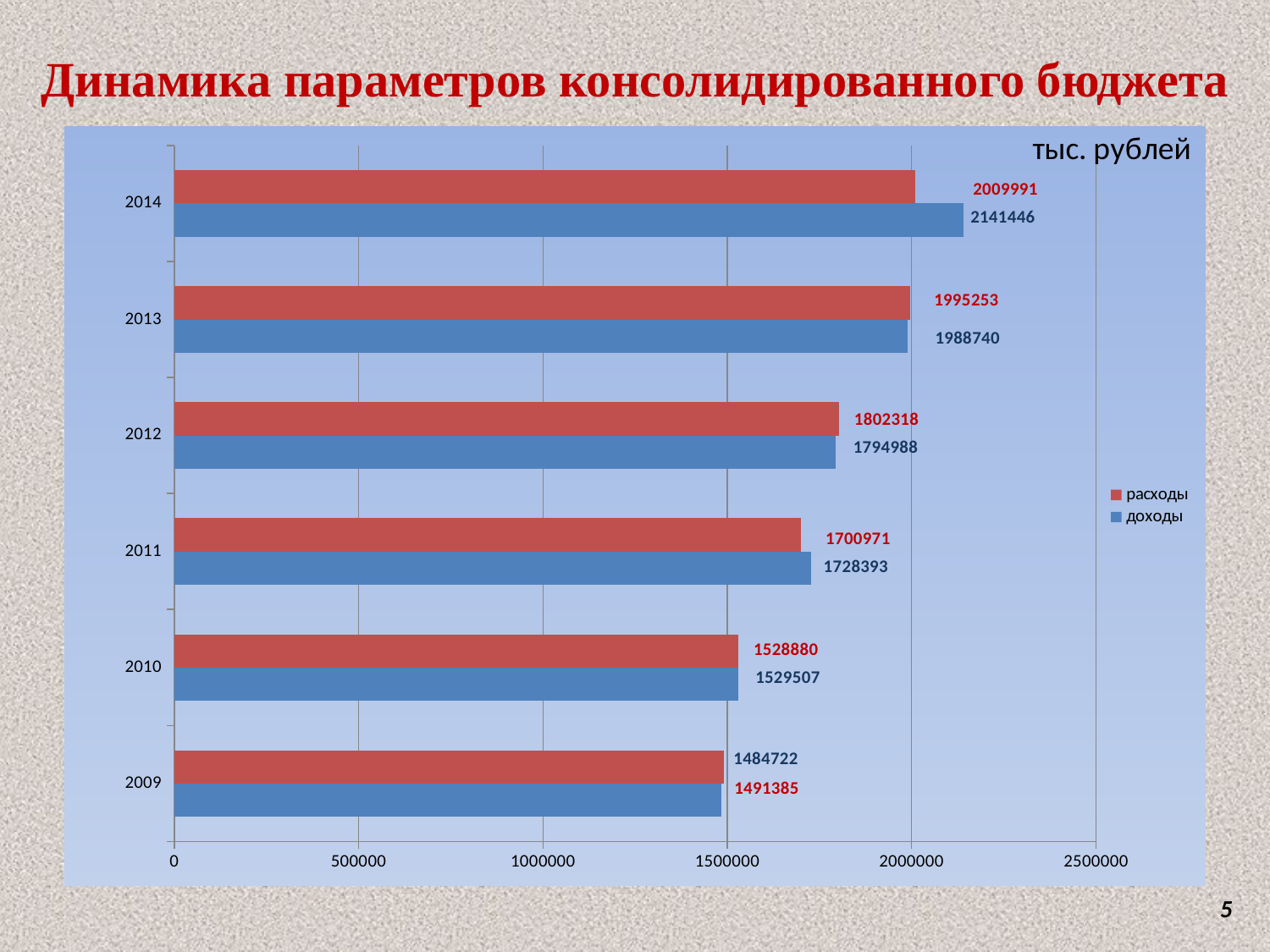
In 2012, which is larger: расходы or доходы? расходы Which year has the highest value of доходы? 2014 What is the difference between расходы and доходы in 2013? 6513 How many series does the legend list? 2 What is the value of расходы for 2010? 1528880 Is the value of расходы for 2011 greater or less than 1500000? greater What is the value of расходы for 2013? 1995253 What is the difference between доходы and расходы in 2014? 131455 What is the value of доходы for 2014? 2141446 What kind of chart is shown on the slide? bar chart What is the value of доходы for 2011? 1728393 How many years are shown on the chart? 6